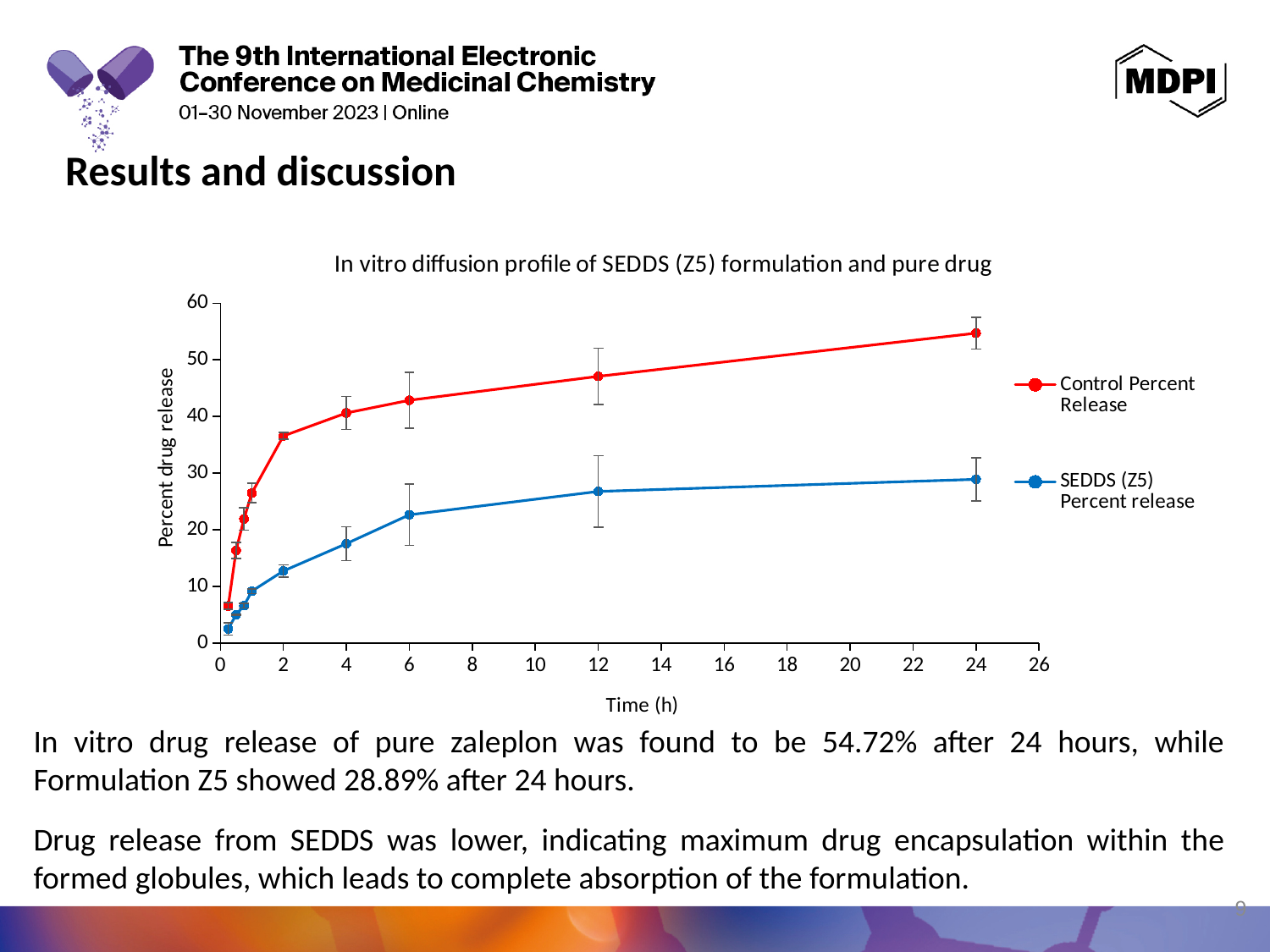
Is the Control Percent Release value at 24 hours greater or less than 50? greater What is the label of the x axis of the chart? Time (h) Is the Control Percent Release value at 2 hours greater or less than 30? greater Is the SEDDS (Z5) Percent release value at 2 hours greater or less than 20? less According to the slide, what was the drug release of Formulation Z5 after 24 hours? 28.89% Does the Control Percent Release series rise or fall as time increases? Rise What is the title of the chart? In vitro diffusion profile of SEDDS (Z5) formulation and pure drug What type of chart is shown on the slide? Line chart According to the slide, what was the in vitro drug release of pure zaleplon after 24 hours? 54.72% How many series does the chart legend list? 2 Which series has the higher percent drug release at 24 hours, Control Percent Release or SEDDS (Z5) Percent release? Control Percent Release